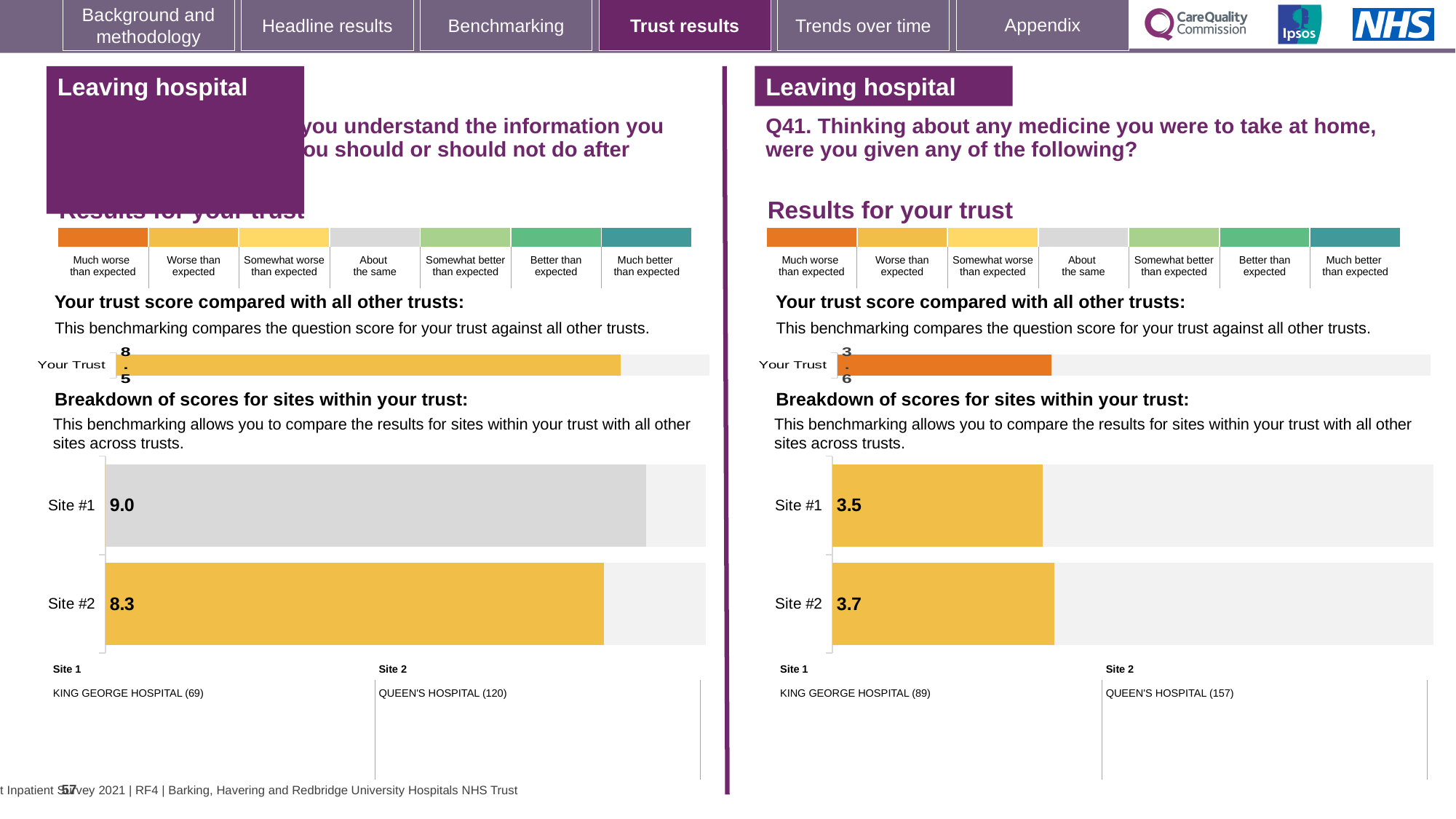
In the Q41 site breakdown chart on the right-hand side of the slide, what is the score for Site #1? 3.5 In the site breakdown chart on the left-hand side of the slide, what is the score for Site #2? 8.3 In the site breakdown chart on the left-hand side of the slide, what is the score for Site #1? 9.0 In the site breakdown chart on the left-hand side of the slide, which site has the higher score? Site #1 What type of chart is used for the site breakdown on the left-hand side of the slide? Bar chart In the Q41 'Your trust score compared with all other trusts' chart on the right-hand side of the slide, what is the score shown for Your Trust? 3.6 In the 'Your trust score compared with all other trusts' chart on the left-hand side of the slide, what is the score shown for Your Trust? 8.5 In the Q41 site breakdown chart on the right-hand side of the slide, what is the score for Site #2? 3.7 How many sites are shown in the Q41 site breakdown chart on the right-hand side of the slide? 2 In the Q41 site breakdown chart on the right-hand side of the slide, which site has the lower score? Site #1 In the site breakdown chart on the left-hand side of the slide, what is the difference between the Site #1 and Site #2 scores? 0.7 In the Q41 site breakdown chart on the right-hand side of the slide, what is the difference between the Site #2 and Site #1 scores? 0.2